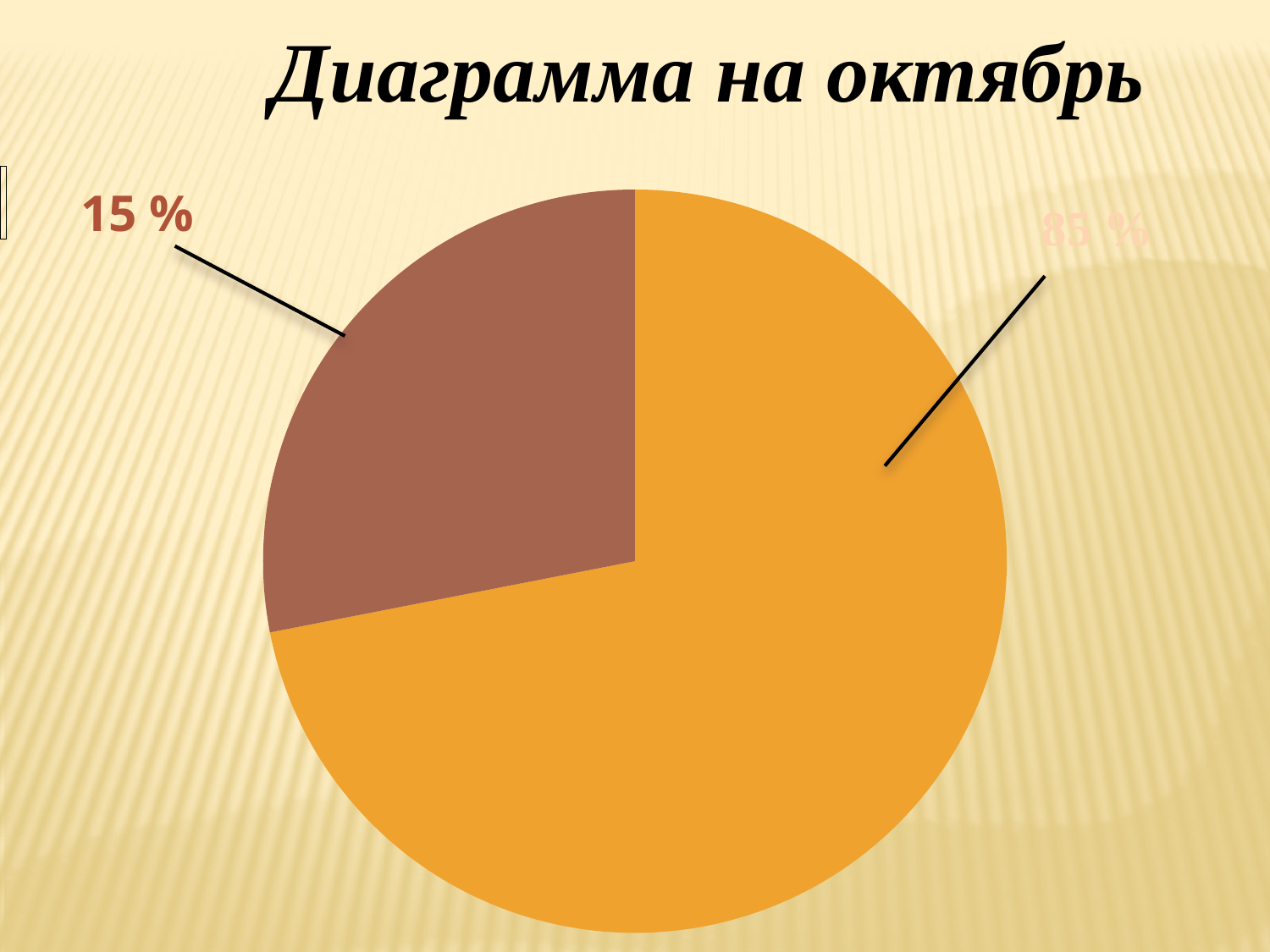
Which slice of the pie chart is the largest? the orange slice (85 %) Which is larger, the orange slice or the brown slice? the orange slice What kind of chart is shown on the slide? pie chart What percentage is labelled on the brown slice of the pie chart? 15 % What percentage is labelled on the orange slice of the pie chart? 85 % What colour is the slice labelled 15 %? brown Which slice of the pie chart is the smallest? the brown slice (15 %) What is the difference in percentage points between the orange slice and the brown slice? 70 What do the two labelled slices of the pie chart add up to? 100 % How many slices does the pie chart have? 2 What is the title of the chart? Диаграмма на октябрь